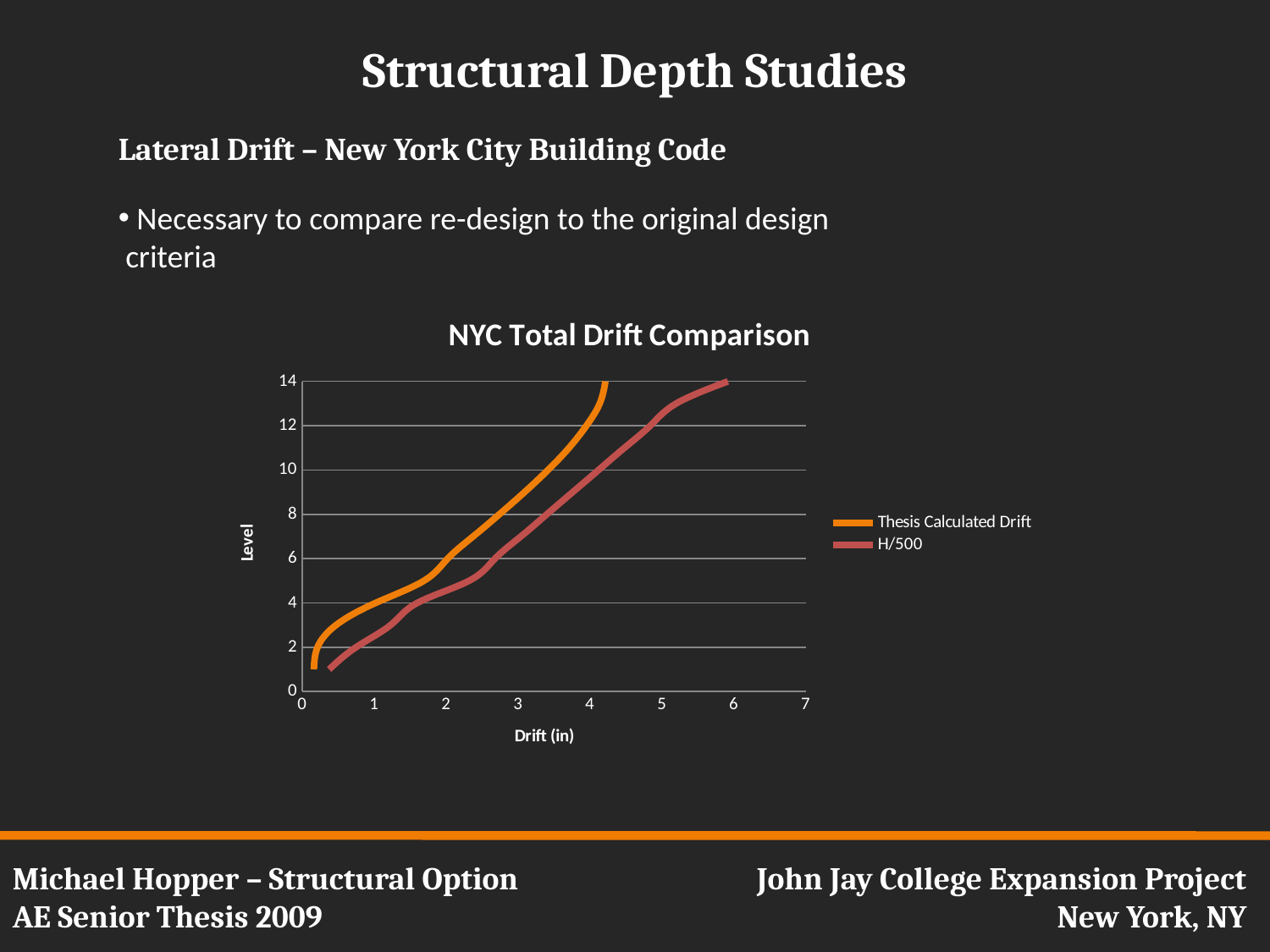
At level 14, which series shows the larger drift, Thesis Calculated Drift or H/500? H/500 What is the label of the horizontal axis of the chart? Drift (in) How many series does the chart legend list? 2 Does the level rise or fall as drift increases along the x axis for the Thesis Calculated Drift series? rise Is the drift for the Thesis Calculated Drift series at level 14 greater or less than 3? greater Is the drift for the H/500 series at level 14 greater or less than 5? greater What type of chart is shown on the slide? line chart Is the drift for the Thesis Calculated Drift series at level 2 greater or less than 1? less At level 6, which series shows the larger drift, Thesis Calculated Drift or H/500? H/500 What is the title of the chart? NYC Total Drift Comparison